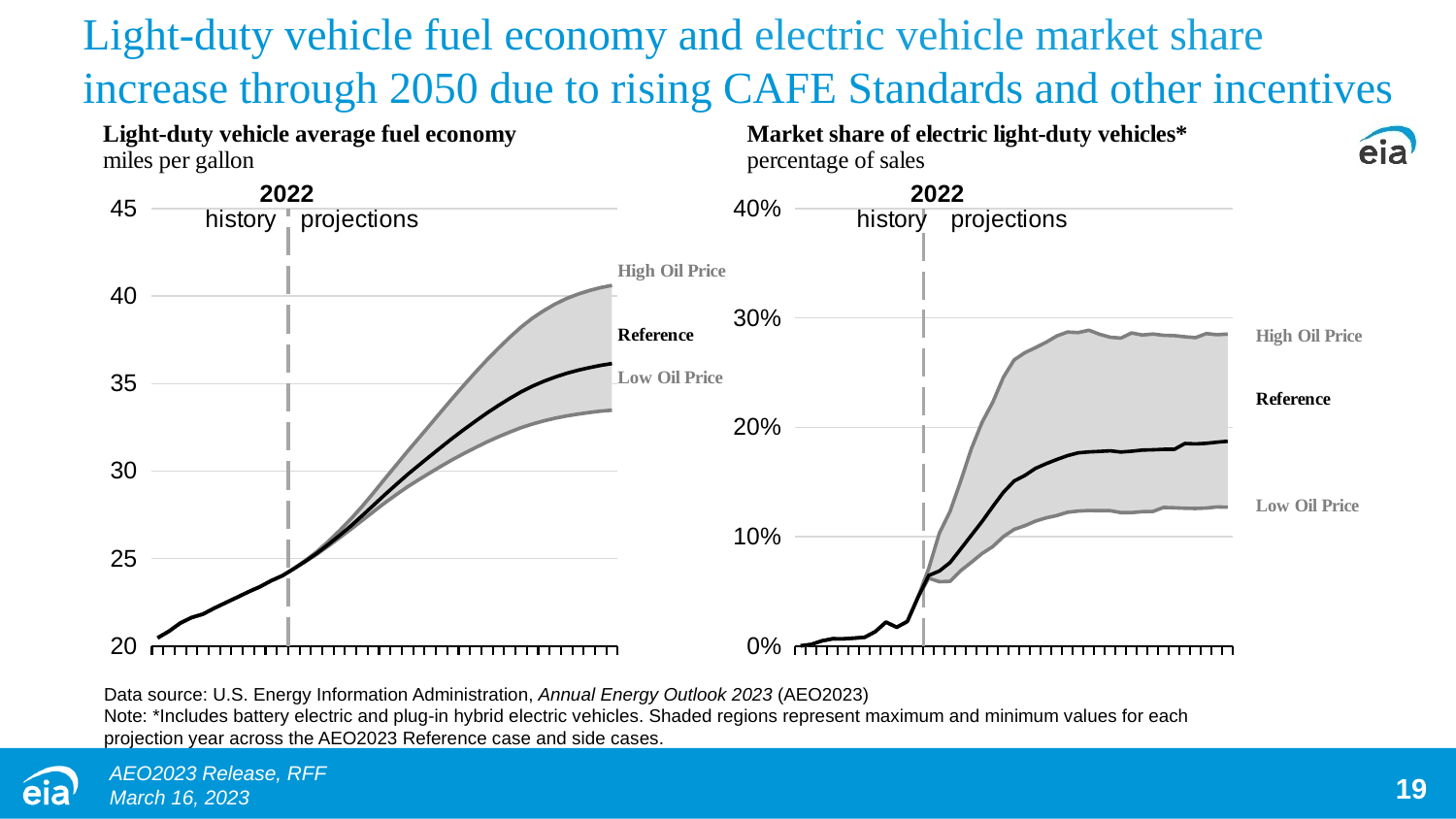
In the 'Market share of electric light-duty vehicles' chart, is the Low Oil Price value at the end of the projection greater or less than 10%? greater In the 'Light-duty vehicle average fuel economy' chart, is the Reference value at the end of the projection greater or less than 35? greater In the 'Light-duty vehicle average fuel economy' chart, does the Reference line rise or fall over the projection period? rise What kind of chart is the 'Light-duty vehicle average fuel economy' chart? line chart In the 'Light-duty vehicle average fuel economy' chart, is the High Oil Price value at the end of the projection greater or less than 40? greater In the 'Market share of electric light-duty vehicles' chart, what is the highest value shown on the vertical axis? 40% In the 'Market share of electric light-duty vehicles' chart, which case ends higher at the end of the projection, High Oil Price or Low Oil Price? High Oil Price How many labeled cases (lines) are shown in the 'Light-duty vehicle average fuel economy' chart? 3 In the 'Light-duty vehicle average fuel economy' chart, what unit is plotted on the vertical axis? miles per gallon